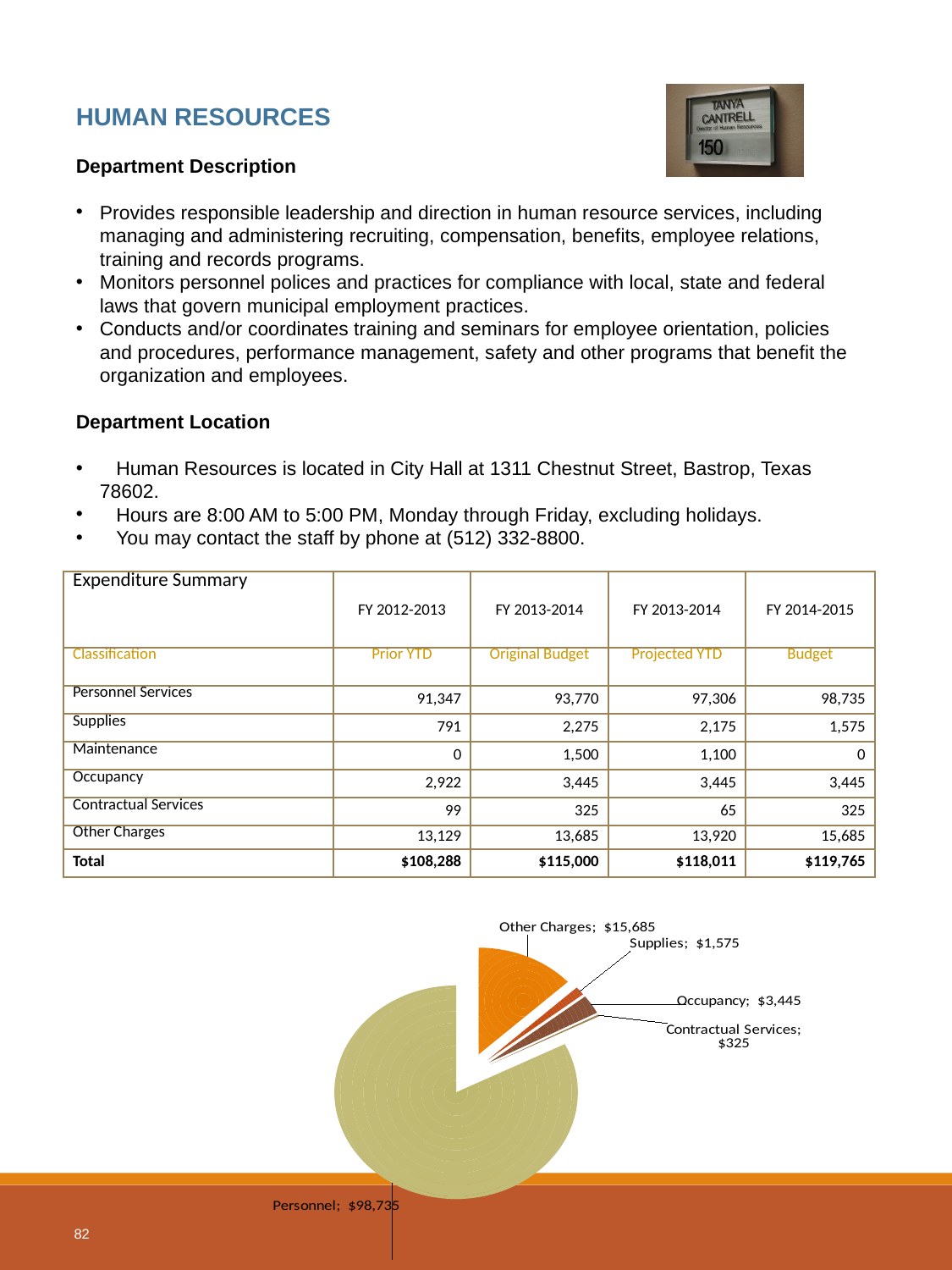
In the pie chart, what is the value for Other Charges? $15,685 Which slice of the pie chart is the largest? Personnel In the pie chart, what is the value for Occupancy? $3,445 In the pie chart, which is larger: Occupancy or Supplies? Occupancy In the pie chart, what is the value for Personnel? $98,735 Which slice of the pie chart is the smallest? Contractual Services In the pie chart, what is the difference between Other Charges and Occupancy? $12,240 What kind of chart is shown at the bottom of the slide? pie chart In the pie chart, which category is shown as the orange slice? Other Charges How many slices does the pie chart have? 5 In the pie chart, what is the value for Supplies? $1,575 In the pie chart, what is the value for Contractual Services? $325